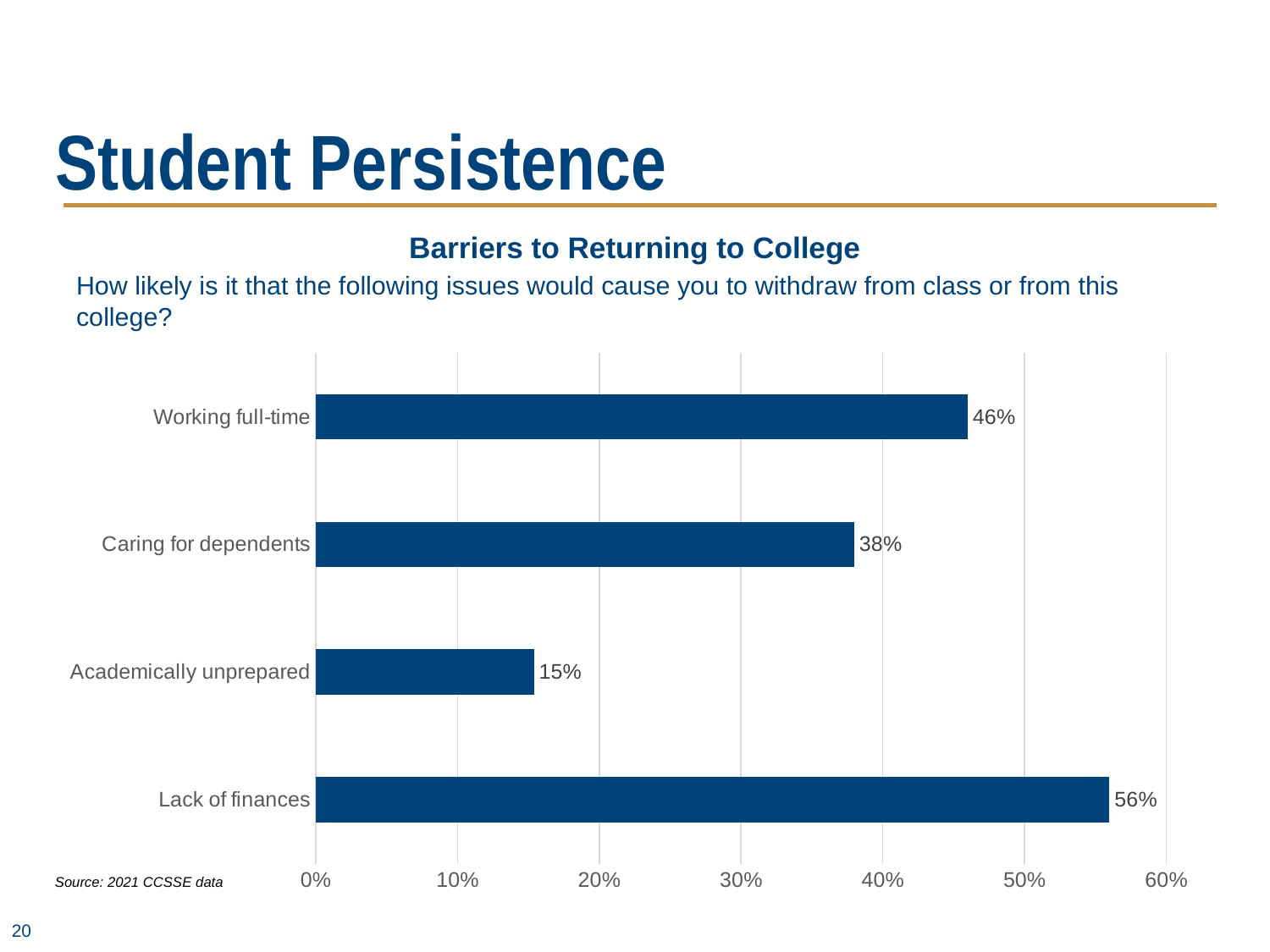
Is the value for Caring for dependents greater or less than 40%? less What is the value for Working full-time? 46% What kind of chart is shown on the slide? Bar chart What is the difference between the values for Caring for dependents and Academically unprepared? 23% What is the value for Academically unprepared? 15% What is the value for Caring for dependents? 38% What is the value for Lack of finances? 56% Which barrier has the highest value? Lack of finances How many barriers are shown in the chart? 4 Which barrier has the lowest value? Academically unprepared Which is larger, the value for Working full-time or the value for Caring for dependents? Working full-time What is the difference between the values for Lack of finances and Working full-time? 10%